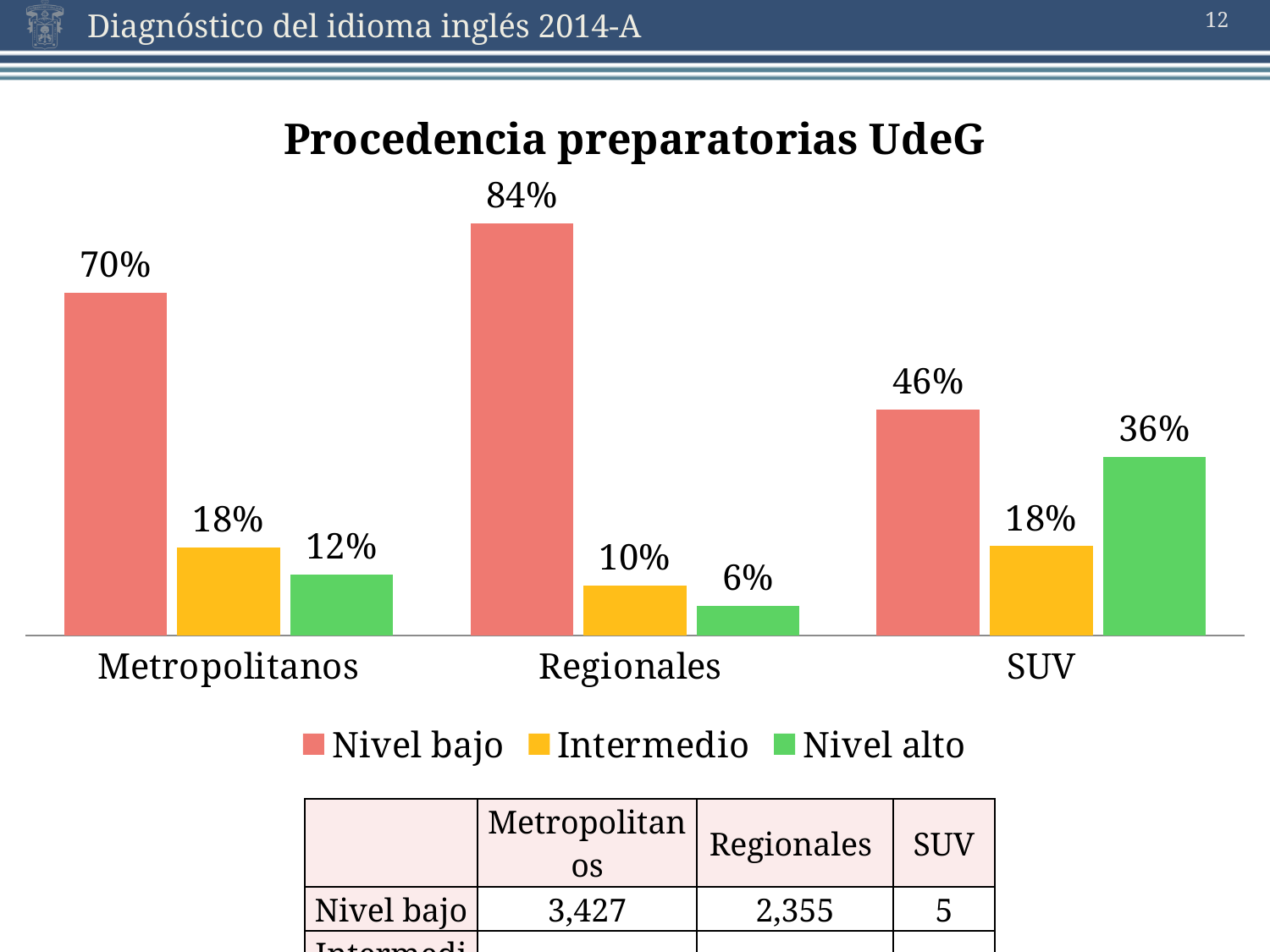
Which category has the highest Nivel bajo value? Regionales What kind of chart is shown? Bar chart What is the title of the chart? Procedencia preparatorias UdeG Which is larger for SUV: Nivel bajo or Nivel alto? Nivel bajo Which category has the lowest Nivel alto value? Regionales How many series does the legend list? 3 What is the Intermedio value for Metropolitanos? 18% What is the Nivel alto value for SUV? 36% What is the difference between the Nivel bajo values for Regionales and Metropolitanos? 14% What is the Nivel bajo value for Regionales? 84% How many categories are shown on the x axis? 3 Which colour represents Intermedio in the legend? Yellow